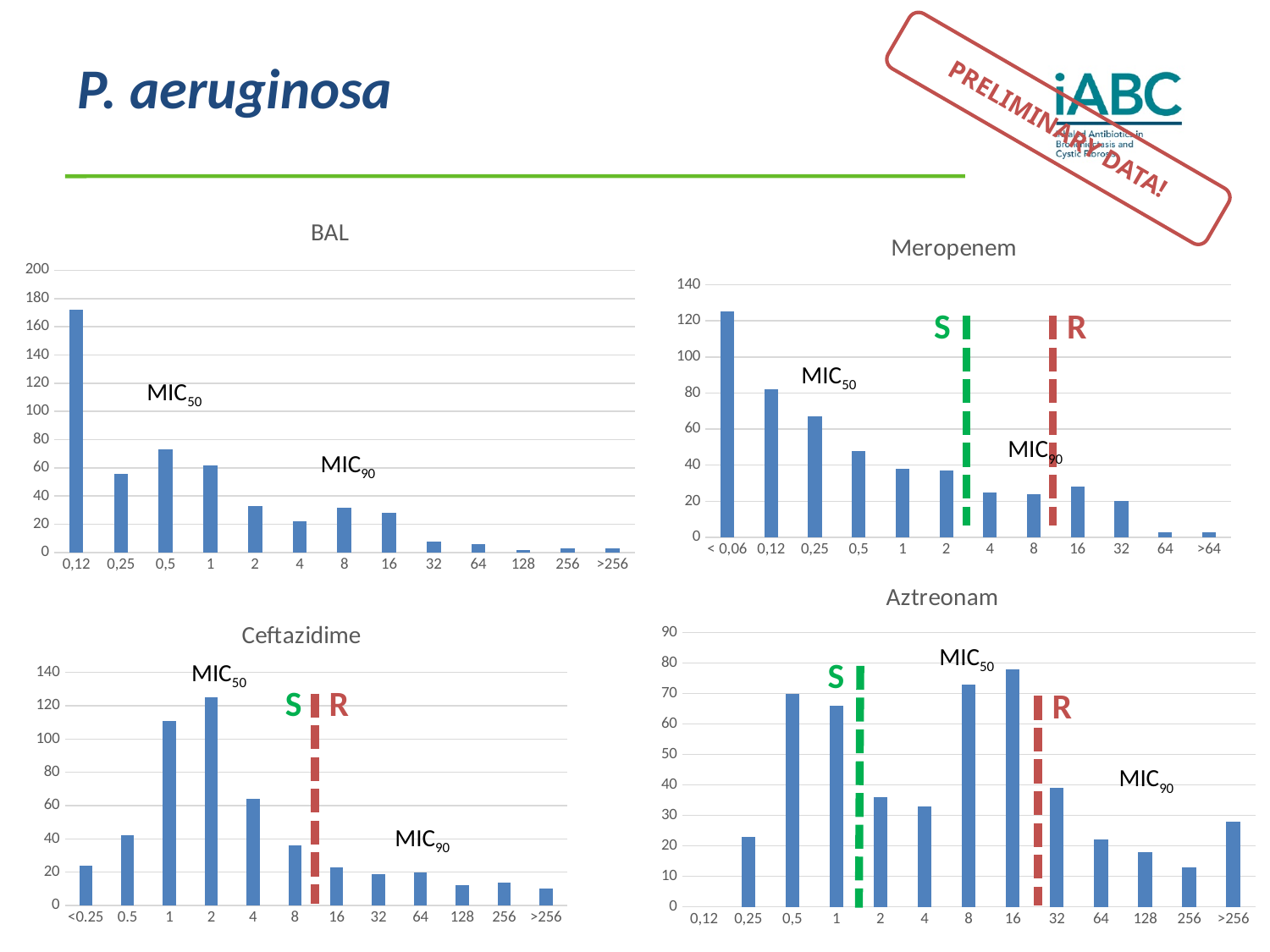
In the Aztreonam chart, is the value for 256 greater or less than 20? less In the Meropenem chart, which category has the highest value? < 0,06 How many categories are shown on the x axis of the BAL chart? 13 In the Meropenem chart, is the value for 0,5 greater or less than 60? less What kind of chart is the BAL chart? bar chart In the BAL chart, is the value for 0,12 greater or less than 160? greater In the BAL chart, which category has the highest value? 0,12 In the Meropenem chart, do the values rise or fall from < 0,06 to 1 along the x axis? fall In the Ceftazidime chart, which category has the highest value? 2 In the Ceftazidime chart, between which two x-axis categories are the S and R dashed lines placed? 8 and 16 In the Ceftazidime chart, which is larger, the value for 4 or the value for 8? 4